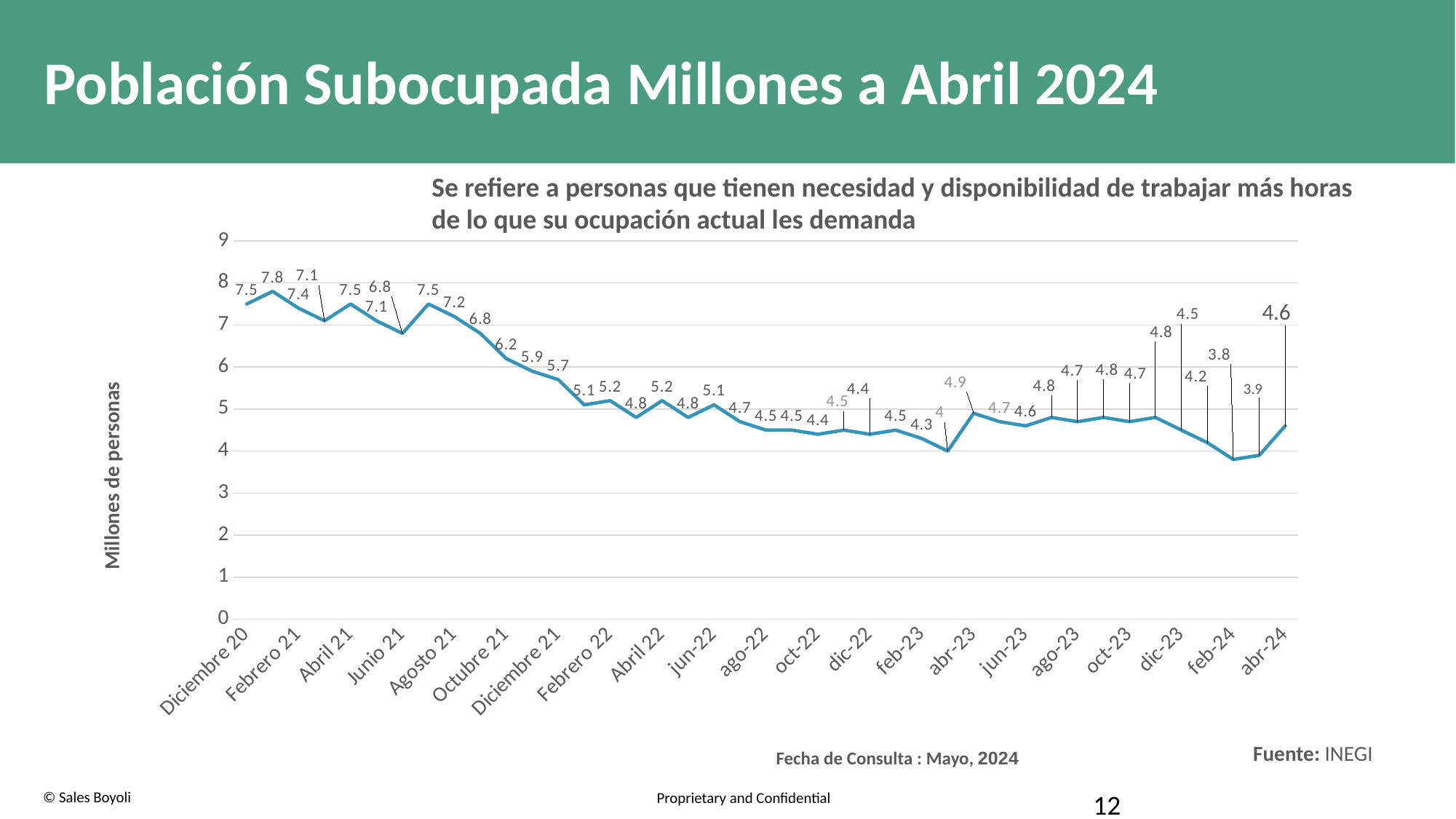
What is the value for Octubre 21? 6.2 What is the value for Diciembre 20? 7.5 What is the difference between the value for Diciembre 20 and the value for abr-24? 2.9 Which is larger, the value for Diciembre 21 or the value for jun-22? Diciembre 21 What is the label of the y axis? Millones de personas What is the value for feb-24? 3.8 What is the value for abr-23? 4.9 What type of chart is shown on the slide? line chart Do the values generally rise or fall from Diciembre 20 to abr-24? fall Which labeled month on the x axis has the lowest value? feb-24 What source is cited for the chart data? INEGI What is the value for abr-24? 4.6